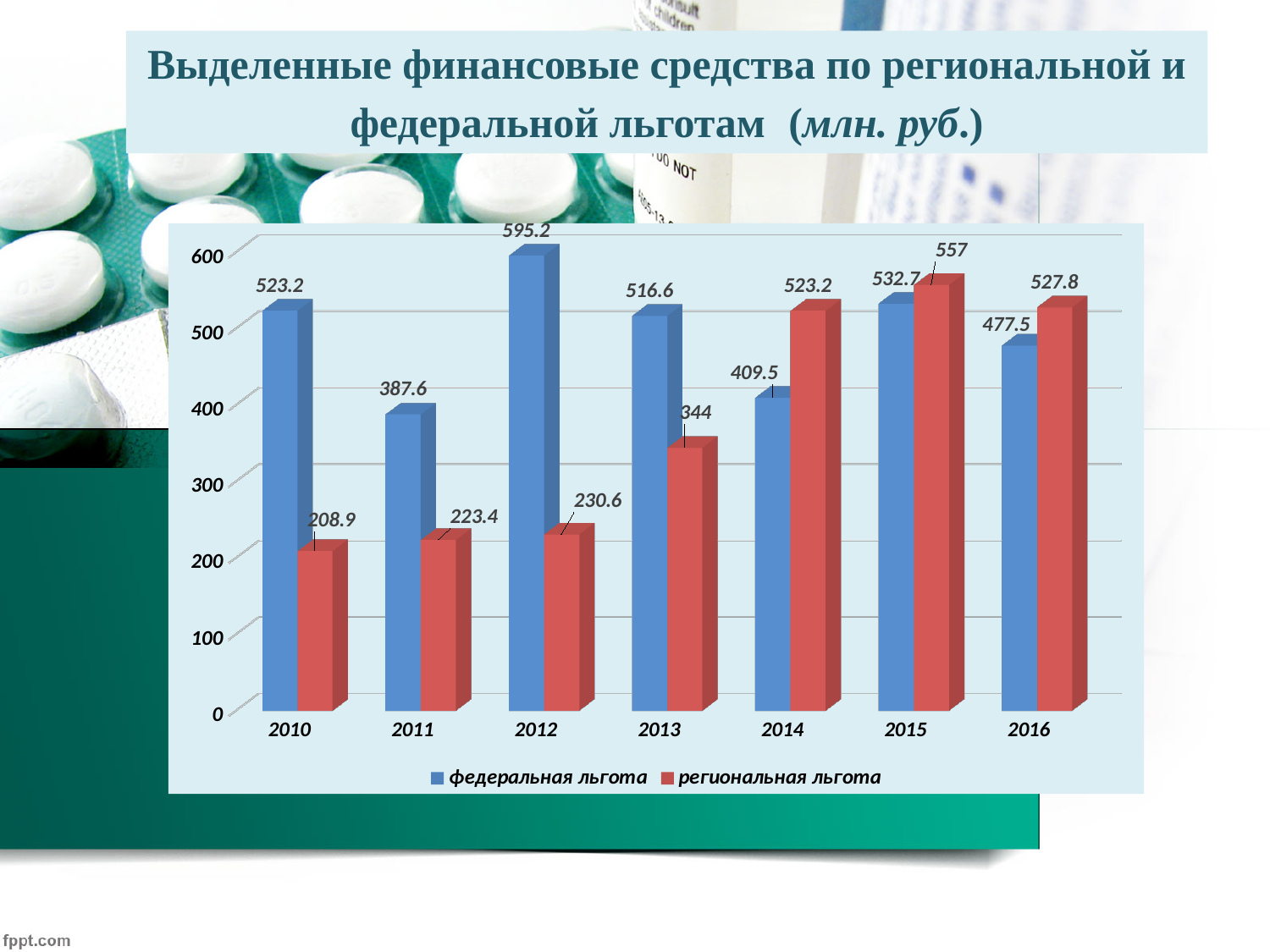
What is the value for региональная льгота in 2013? 344 In which year is федеральная льгота highest? 2012 What is the value for региональная льгота in 2010? 208.9 How many series does the legend list? 2 Which is larger in 2015, федеральная льгота or региональная льгота? региональная льгота In which year is региональная льгота lowest? 2010 What type of chart is shown on the slide? bar chart Which colour represents федеральная льгота in the chart? blue Does региональная льгота rise or fall from 2010 to 2015? rise What is the difference between федеральная льгота and региональная льгота in 2011? 164.2 What is the value for федеральная льгота in 2012? 595.2 How many years are shown on the x axis? 7